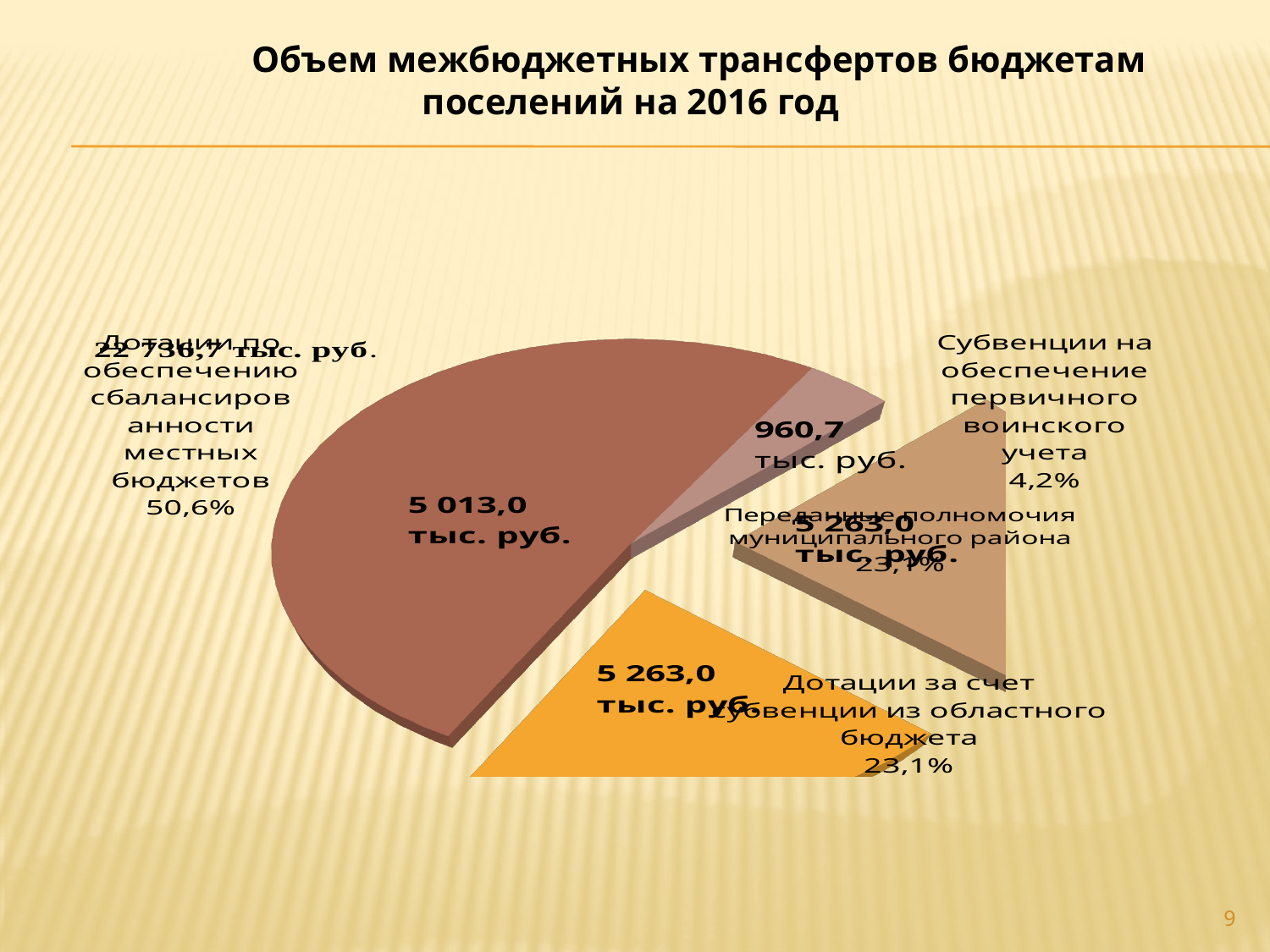
What is the difference in percentage points between the 'Дотации по обеспечению сбалансированности местных бюджетов' slice and the 'Субвенции на обеспечение первичного воинского учета' slice? 46,4 What share of the pie is 'Субвенции на обеспечение первичного воинского учета'? 4,2% Which is larger: the share for 'Дотации по обеспечению сбалансированности местных бюджетов' or the share for 'Переданные полномочия муниципального района'? Дотации по обеспечению сбалансированности местных бюджетов What kind of chart is shown on the slide? pie chart What share of the pie is 'Переданные полномочия муниципального района'? 23,1% Which slice of the pie chart is the largest? Дотации по обеспечению сбалансированности местных бюджетов Which slice of the pie chart is the smallest? Субвенции на обеспечение первичного воинского учета What share of the pie is 'Дотации по обеспечению сбалансированности местных бюджетов'? 50,6% How many slices does the pie chart have? 4 Is the share for 'Дотации по обеспечению сбалансированности местных бюджетов' greater or less than 50%? greater What is the title of the slide? Объем межбюджетных трансфертов бюджетам поселений на 2016 год